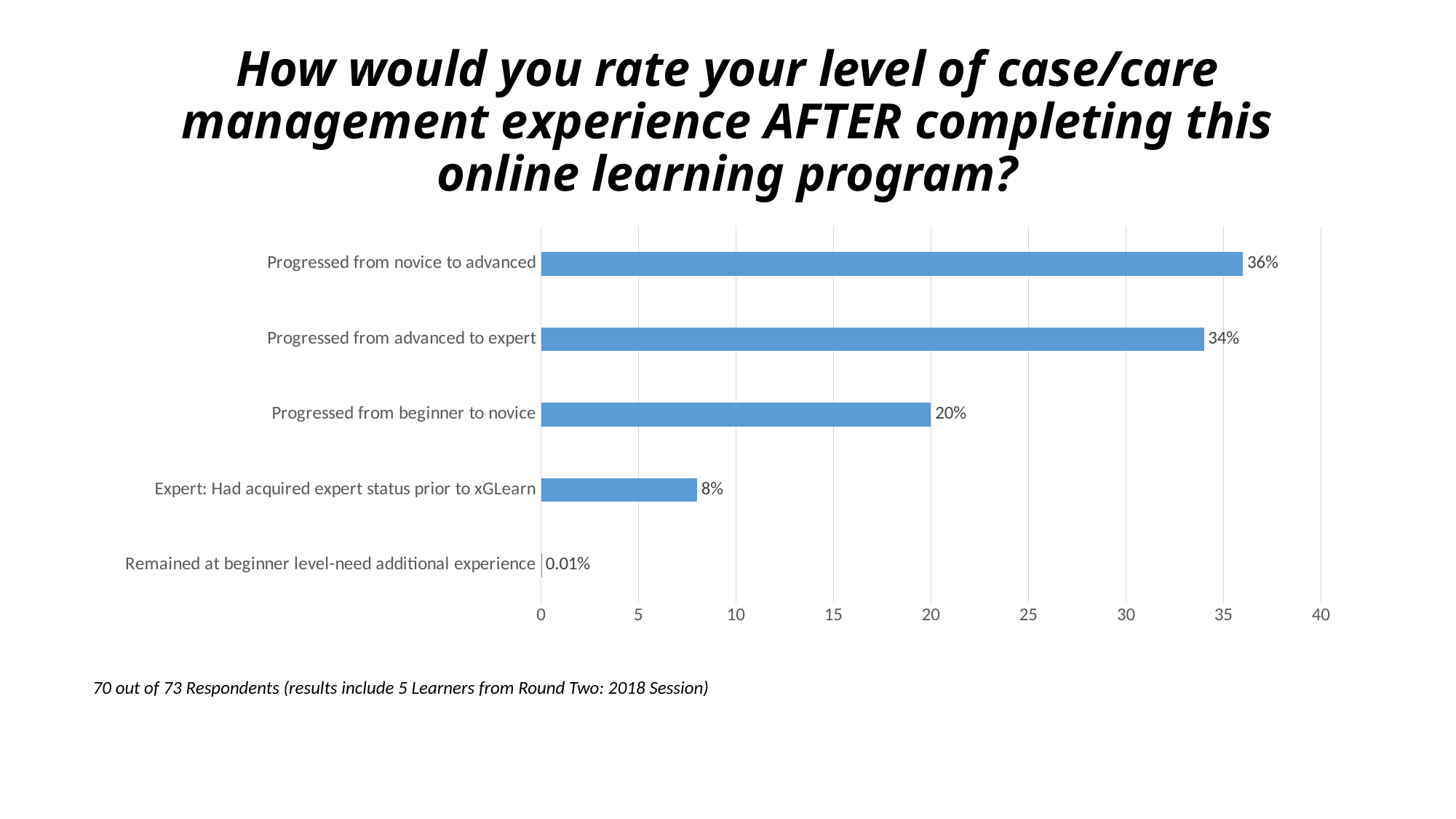
What is the maximum value shown on the horizontal axis? 40 What kind of chart is shown on the slide? Bar chart How many categories are shown in the chart? 5 What is the value for 'Expert: Had acquired expert status prior to xGLearn'? 8% Which is larger: 'Progressed from beginner to novice' or 'Expert: Had acquired expert status prior to xGLearn'? Progressed from beginner to novice What is the value for 'Progressed from novice to advanced'? 36% What is the value for 'Progressed from beginner to novice'? 20% What is the value for 'Remained at beginner level-need additional experience'? 0.01% Which category has the lowest value? Remained at beginner level-need additional experience What is the difference between 'Progressed from novice to advanced' and 'Progressed from beginner to novice'? 16% Which category has the highest value? Progressed from novice to advanced What is the value for 'Progressed from advanced to expert'? 34%